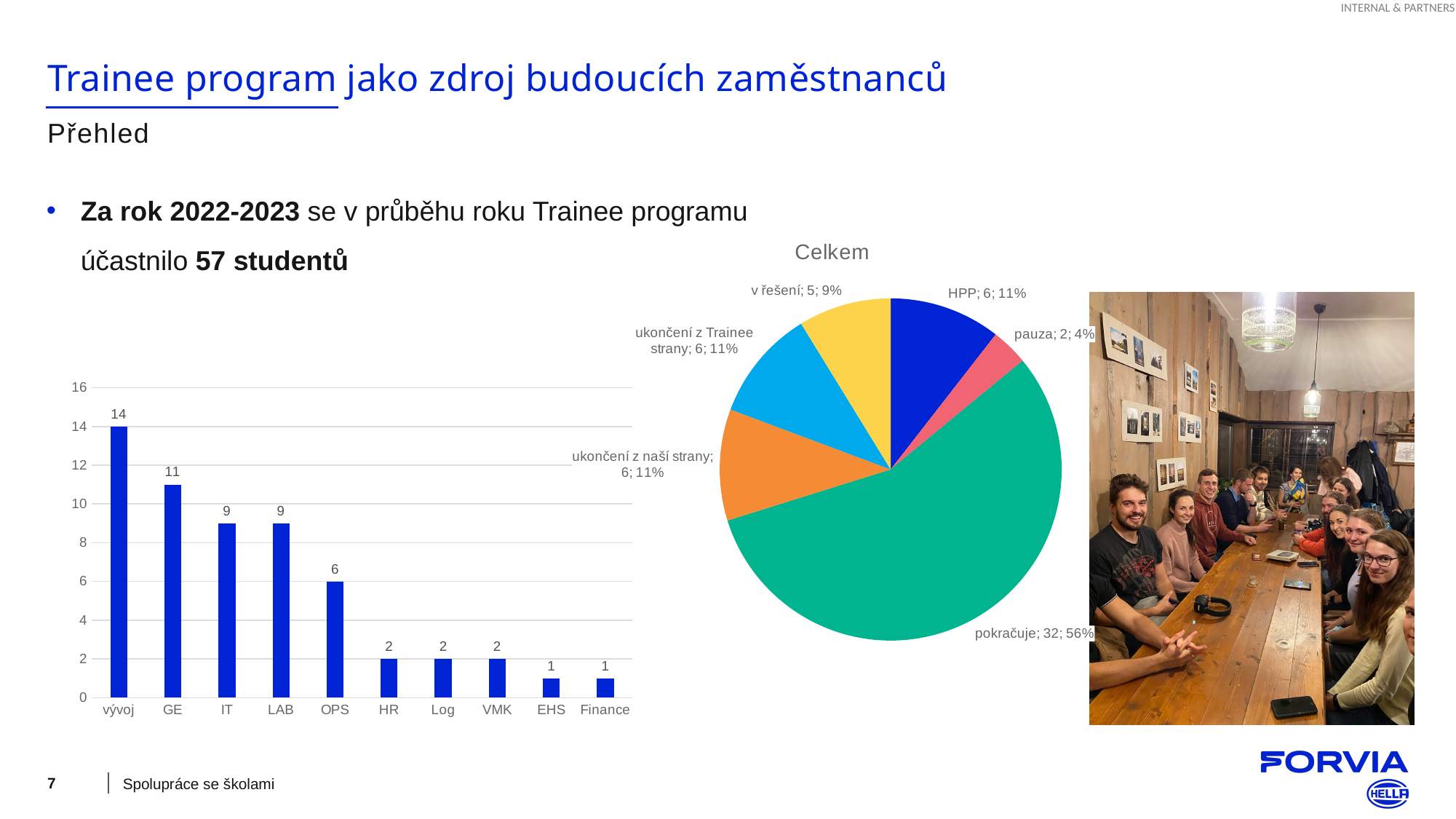
What is the title of the pie chart? Celkem In the bar chart on the left, what is the value for OPS? 6 In the pie chart titled Celkem, what is the value for pokračuje? 32 In the bar chart on the left, what is the difference between the values for vývoj and GE? 3 In the pie chart titled Celkem, which slice is the smallest? pauza In the bar chart on the left, which is larger, the value for GE or the value for IT? GE In the pie chart titled Celkem, what is the value for v řešení? 5 In the bar chart on the left, what is the value for vývoj? 14 In the bar chart on the left, how many categories are shown on the x axis? 10 In the bar chart on the left, which category has the highest value? vývoj In the pie chart titled Celkem, what share does pokračuje have? 56% What kind of chart is the chart on the left? bar chart